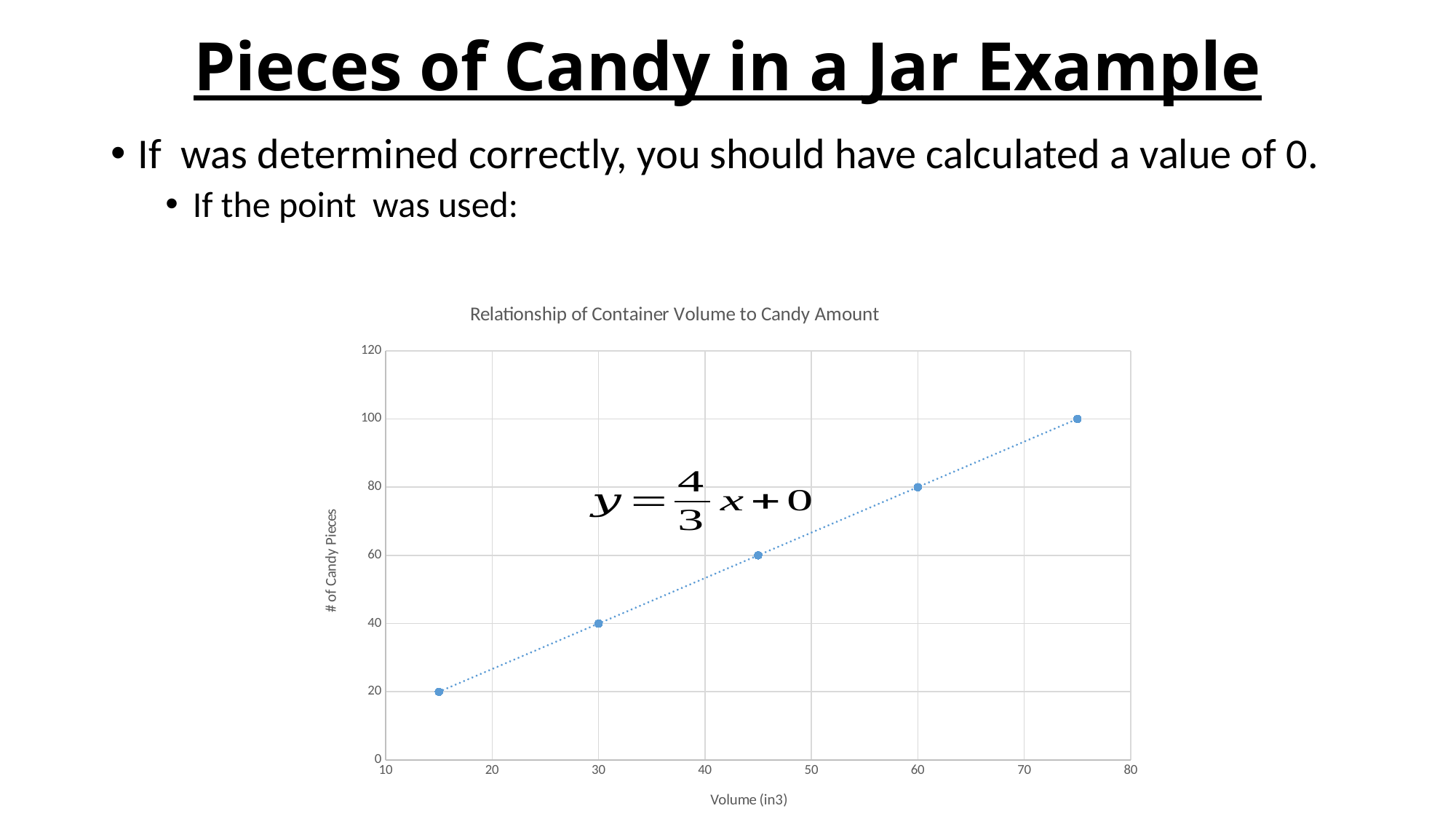
How many data points are plotted on the chart? 5 What is the # of Candy Pieces value for the point at Volume 60? 80 Do the # of Candy Pieces values rise or fall as Volume increases along the x axis? rise What is the difference in # of Candy Pieces between the points at Volume 60 and Volume 30? 40 What is the # of Candy Pieces value for the point at Volume 30? 40 What is the lowest # of Candy Pieces value plotted on the chart? 20 What is the # of Candy Pieces value of the rightmost point on the chart? 100 What is the highest # of Candy Pieces value plotted on the chart? 100 What is the label of the x axis of the chart? Volume (in3) What is the # of Candy Pieces value of the leftmost point on the chart? 20 What kind of chart is shown on the slide? scatter chart What is the title of the chart? Relationship of Container Volume to Candy Amount